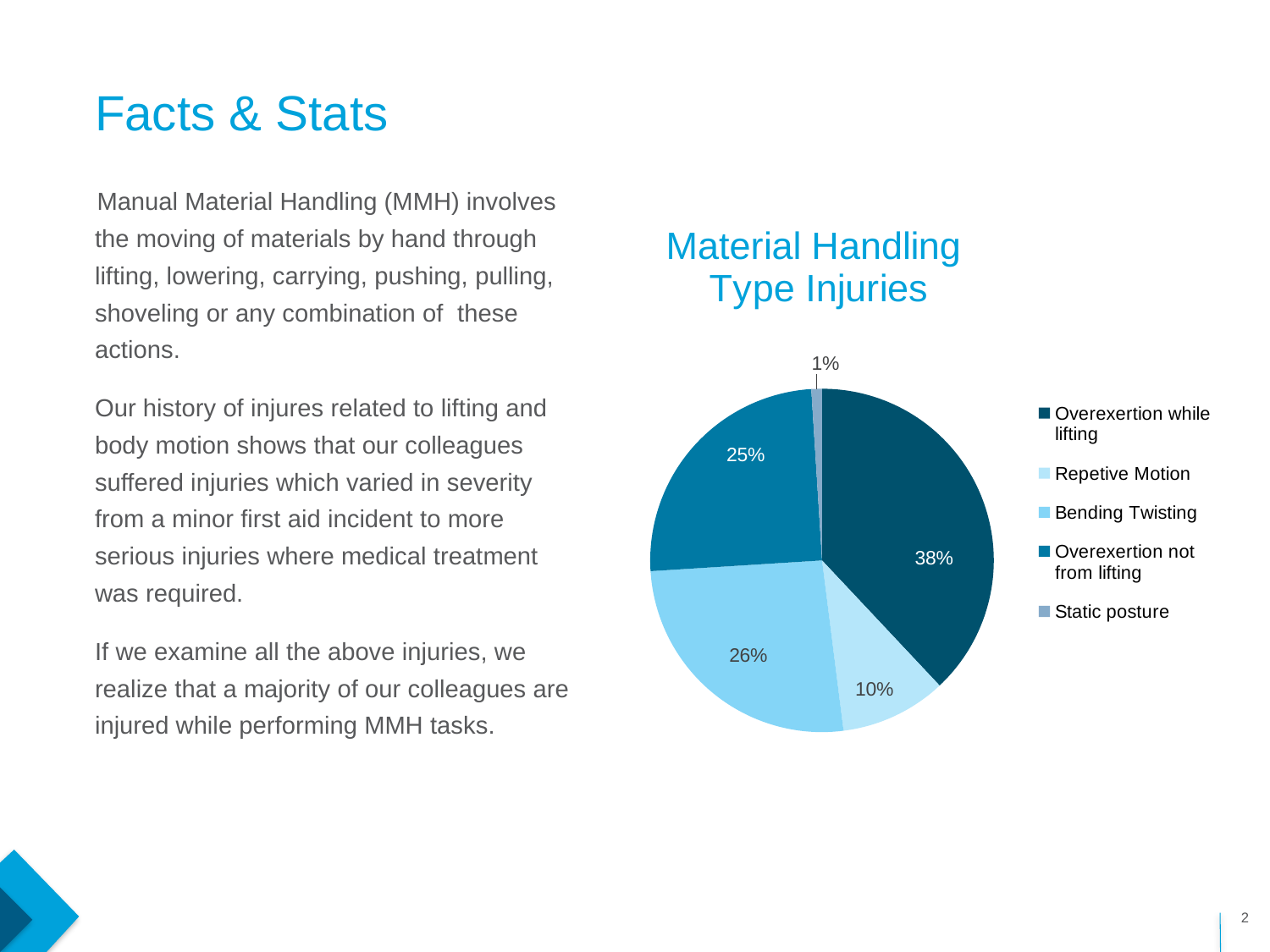
What is the difference in percentage points between Overexertion while lifting and Bending Twisting? 12 Which injury type has the largest share of the pie? Overexertion while lifting What percentage of injuries is attributed to Bending Twisting? 26% What type of chart is shown on the slide? pie chart How many categories does the legend list? 5 What percentage of injuries is attributed to Overexertion not from lifting? 25% Which is larger, the share for Bending Twisting or the share for Repetive Motion? Bending Twisting Which injury type has the smallest share of the pie? Static posture What percentage of injuries is attributed to Overexertion while lifting? 38% What percentage of injuries is attributed to Static posture? 1% What is the title of the chart? Material Handling Type Injuries What percentage of injuries is attributed to Repetive Motion? 10%